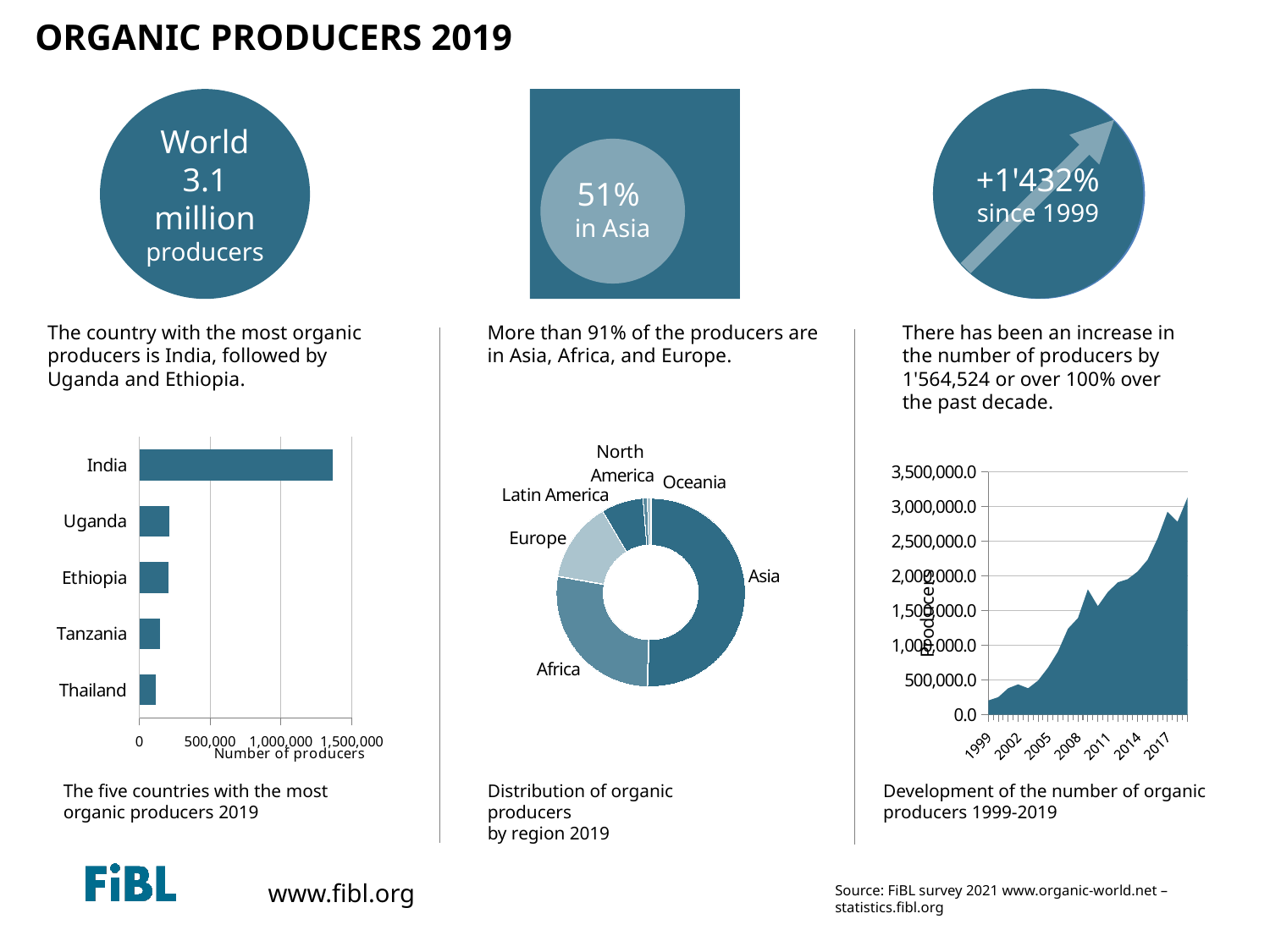
On the chart 'Distribution of organic producers by region 2019', which region has the largest share? Asia On the chart 'Distribution of organic producers by region 2019', how many regions are shown? 6 On the bar chart 'The five countries with the most organic producers 2019', is the value for Uganda greater or less than 500,000? less On the bar chart 'The five countries with the most organic producers 2019', which country has the highest number of producers? India On the chart 'Development of the number of organic producers 1999-2019', is the value for 1999 greater or less than 500,000.0? less On the bar chart 'The five countries with the most organic producers 2019', is the value for India greater or less than 1,000,000? greater What kind of chart is 'The five countries with the most organic producers 2019'? bar chart On the bar chart 'The five countries with the most organic producers 2019', which has more producers, India or Uganda? India On the bar chart 'The five countries with the most organic producers 2019', how many countries are shown? 5 On the bar chart 'The five countries with the most organic producers 2019', which country has the lowest number of producers? Thailand On the chart 'Development of the number of organic producers 1999-2019', do the values generally rise or fall from 1999 to 2019? rise